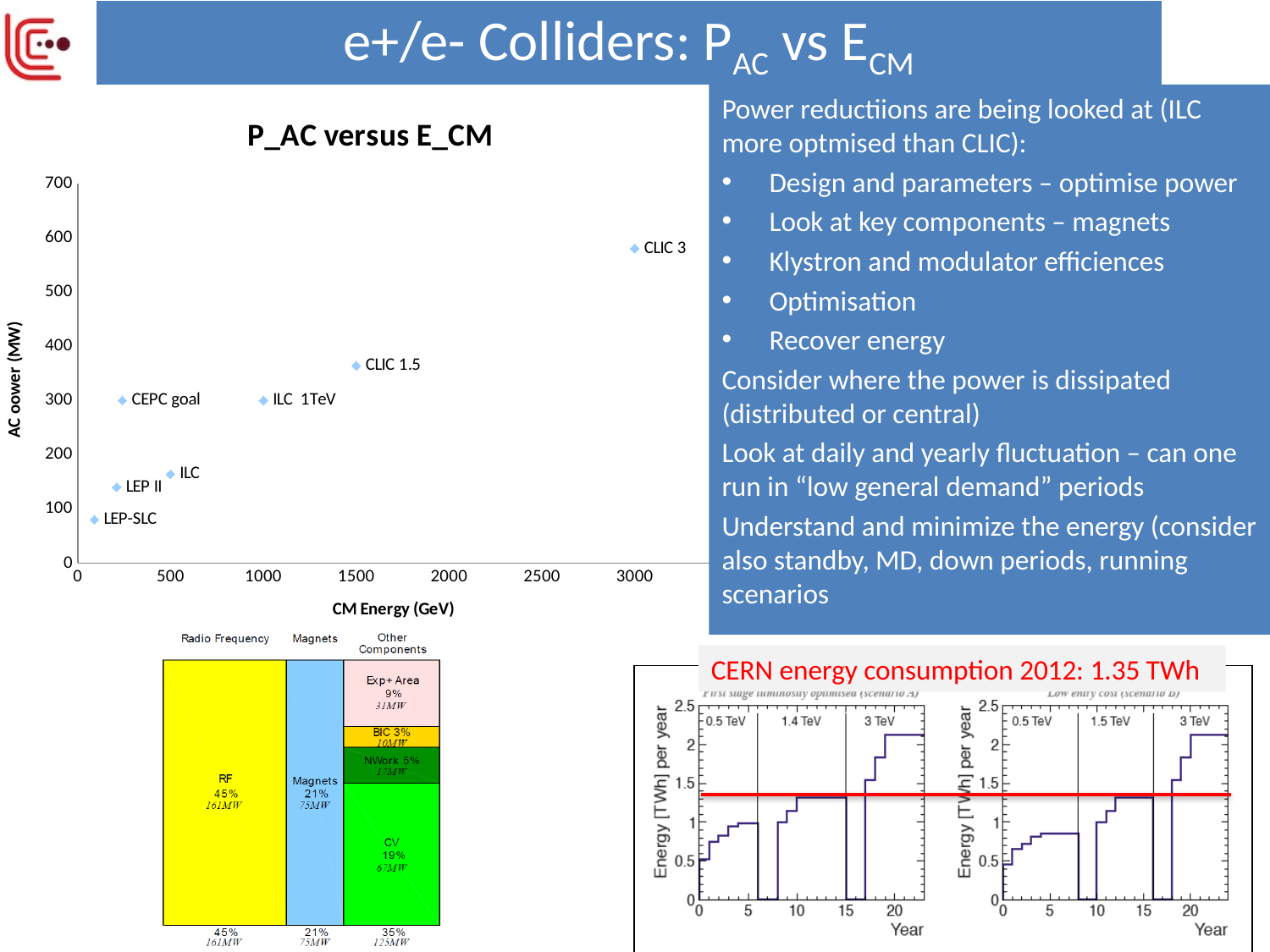
In the chart titled "P_AC versus E_CM", is the AC power for CLIC 1.5 greater or less than 300 MW? greater In the power breakdown chart at the bottom left of the slide, what share of power goes to RF? 45% In the chart titled "P_AC versus E_CM", is the AC power for LEP-SLC greater or less than 100 MW? less How many colliders are plotted in the chart titled "P_AC versus E_CM"? 7 In the chart titled "P_AC versus E_CM", which has the higher AC power, CLIC 3 or CLIC 1.5? CLIC 3 In the chart titled "P_AC versus E_CM", what is the label of the x axis? CM Energy (GeV) In the chart titled "P_AC versus E_CM", which collider has the highest AC power? CLIC 3 In the chart titled "P_AC versus E_CM", is the AC power for ILC greater or less than 200 MW? less In the chart titled "P_AC versus E_CM", which has the higher AC power, ILC or LEP-SLC? ILC In the chart titled "P_AC versus E_CM", which collider has the lowest AC power? LEP-SLC What kind of chart is "P_AC versus E_CM"? scatter chart